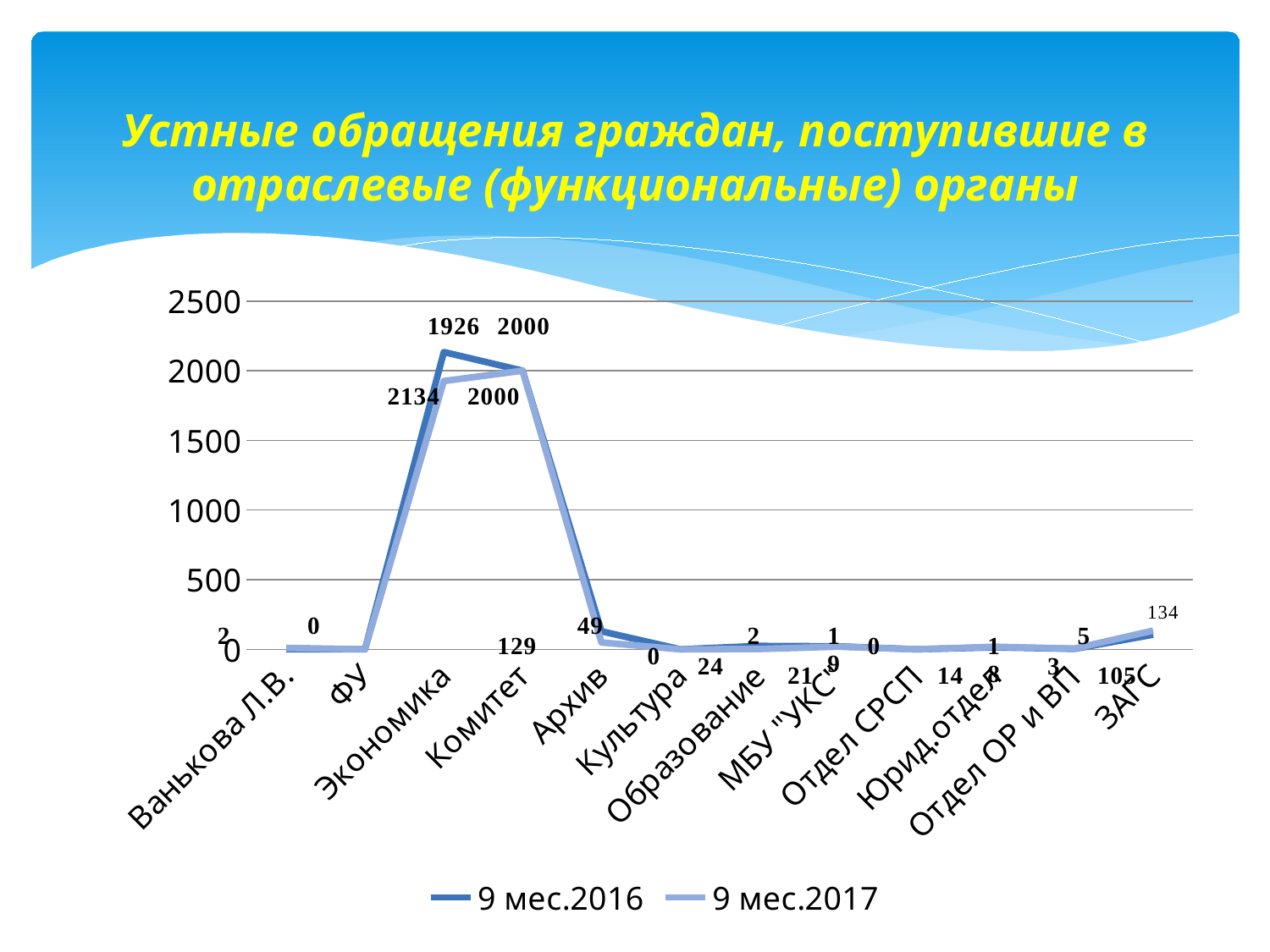
What is the value for Экономика in the 9 мес.2017 series? 1926 How many series does the legend list? 2 What is the value for Экономика in the 9 мес.2016 series? 2134 Is the value for Архив in the 9 мес.2016 series greater or less than 500? less Which is larger in the 9 мес.2016 series: Экономика or Комитет? Экономика What is the value for Комитет in the 9 мес.2017 series? 2000 What are the two series named in the legend? 9 мес.2016 and 9 мес.2017 What kind of chart is shown on the slide? line chart How many categories are shown on the x axis? 12 What is the difference between the 9 мес.2016 and 9 мес.2017 values for Экономика? 208 Which category has the highest value in the 9 мес.2016 series? Экономика What is the value for Комитет in the 9 мес.2016 series? 2000